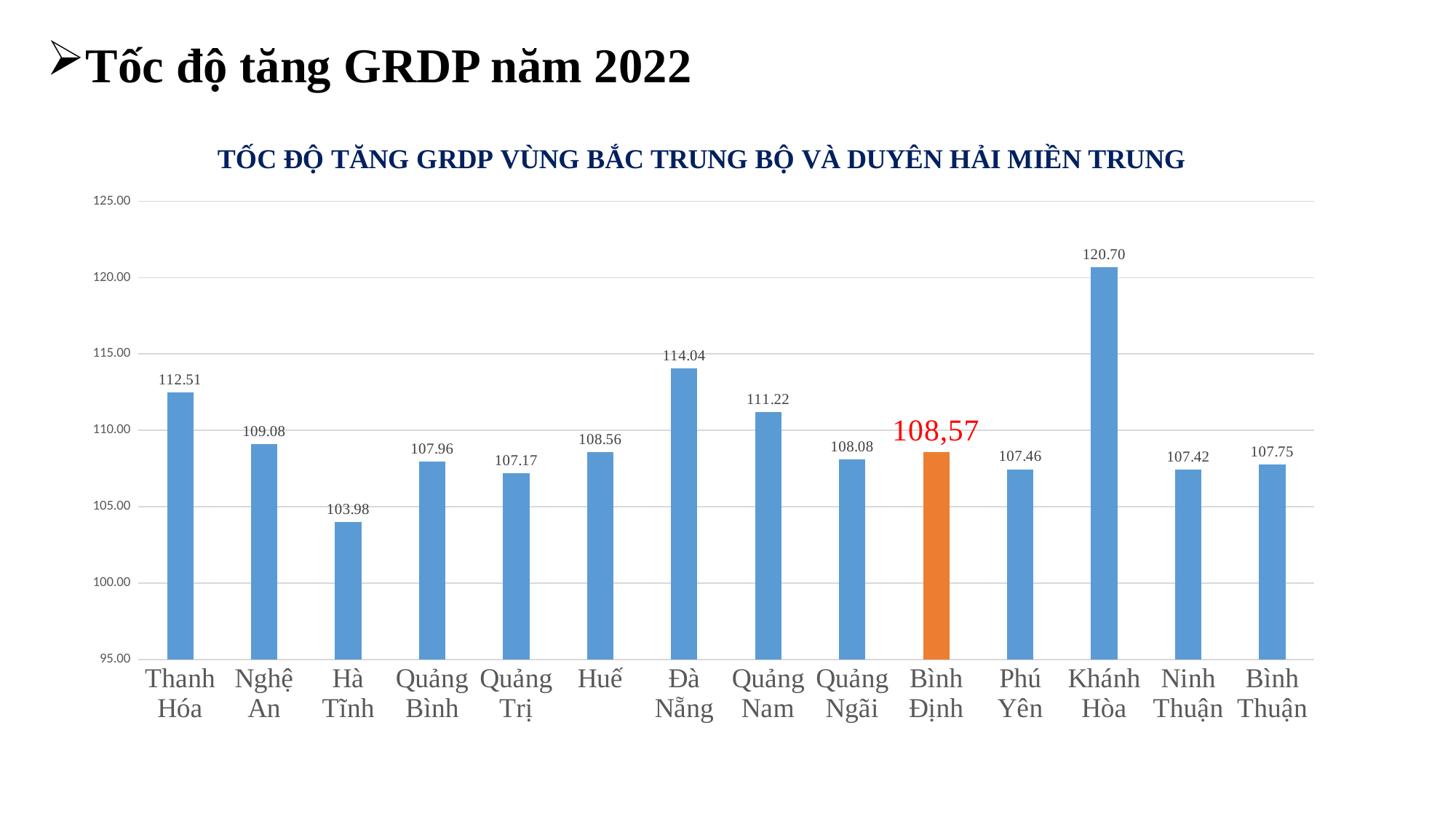
What is the difference between the values for Đà Nẵng and Quảng Nam? 2.82 What is the title of the chart? TỐC ĐỘ TĂNG GRDP VÙNG BẮC TRUNG BỘ VÀ DUYÊN HẢI MIỀN TRUNG What kind of chart is shown on the slide? bar chart What is the value for Khánh Hòa? 120.70 Which province has the lowest value? Hà Tĩnh Is the value for Đà Nẵng greater or less than 115.00? less Which bar is coloured orange instead of blue? Bình Định Which is larger, the value for Thanh Hóa or the value for Nghệ An? Thanh Hóa What is the value for Hà Tĩnh? 103.98 Which province has the highest value? Khánh Hòa How many provinces are shown on the x axis? 14 What is the value shown for Bình Định? 108,57